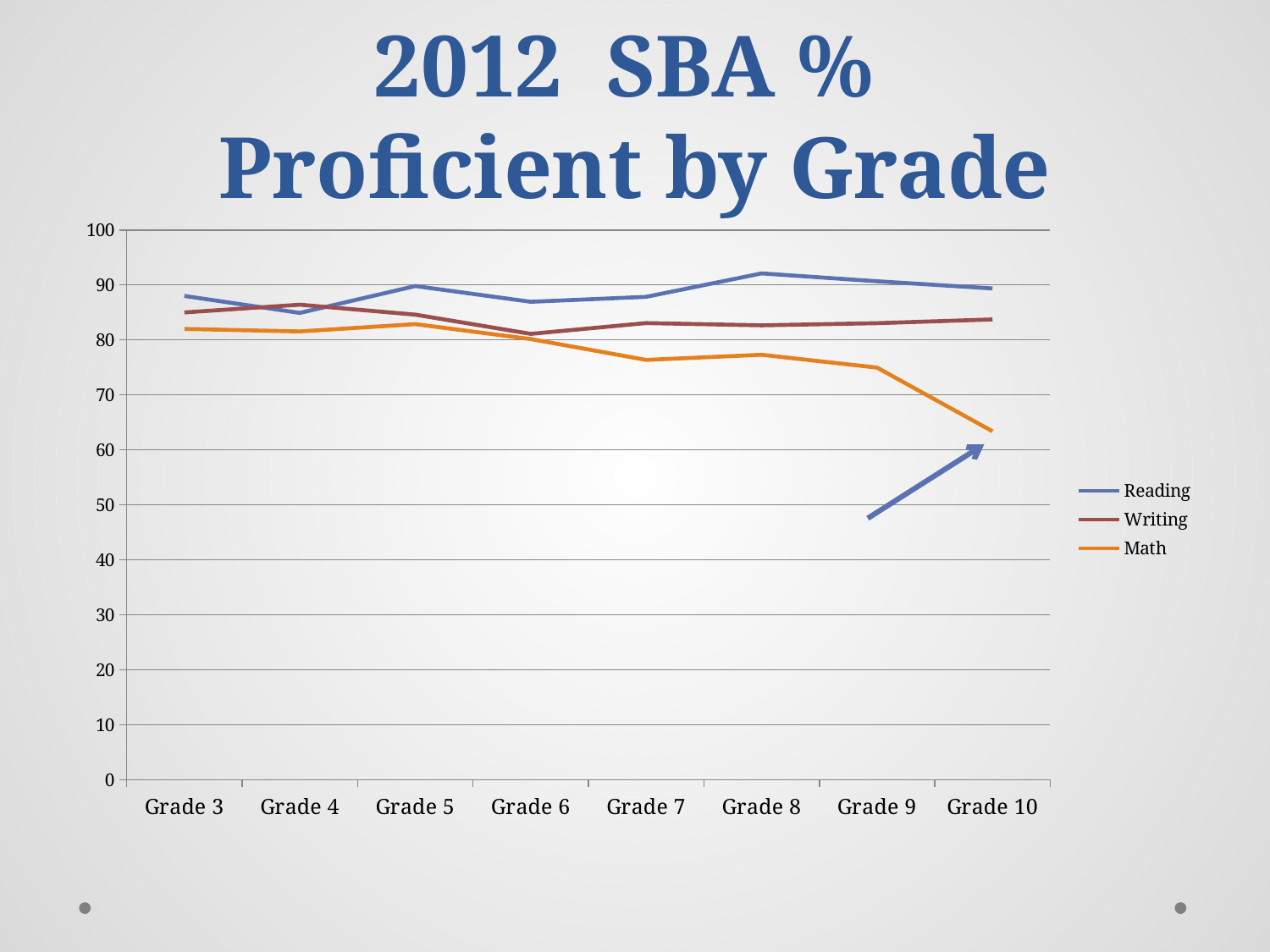
At Grade 10, which is larger, Reading or Math? Reading How many grade levels are plotted along the x axis? 8 Is the Reading value for Grade 8 greater or less than 90? greater What is the title of the chart? 2012 SBA % Proficient by Grade What kind of chart is shown on the slide? line chart At which grade is the Math series lowest? Grade 10 Is the Math value for Grade 7 greater or less than 80? less Is the Math value for Grade 9 greater or less than 70? greater Does the Math series generally rise or fall from Grade 3 to Grade 10? fall How many series does the legend list? 3